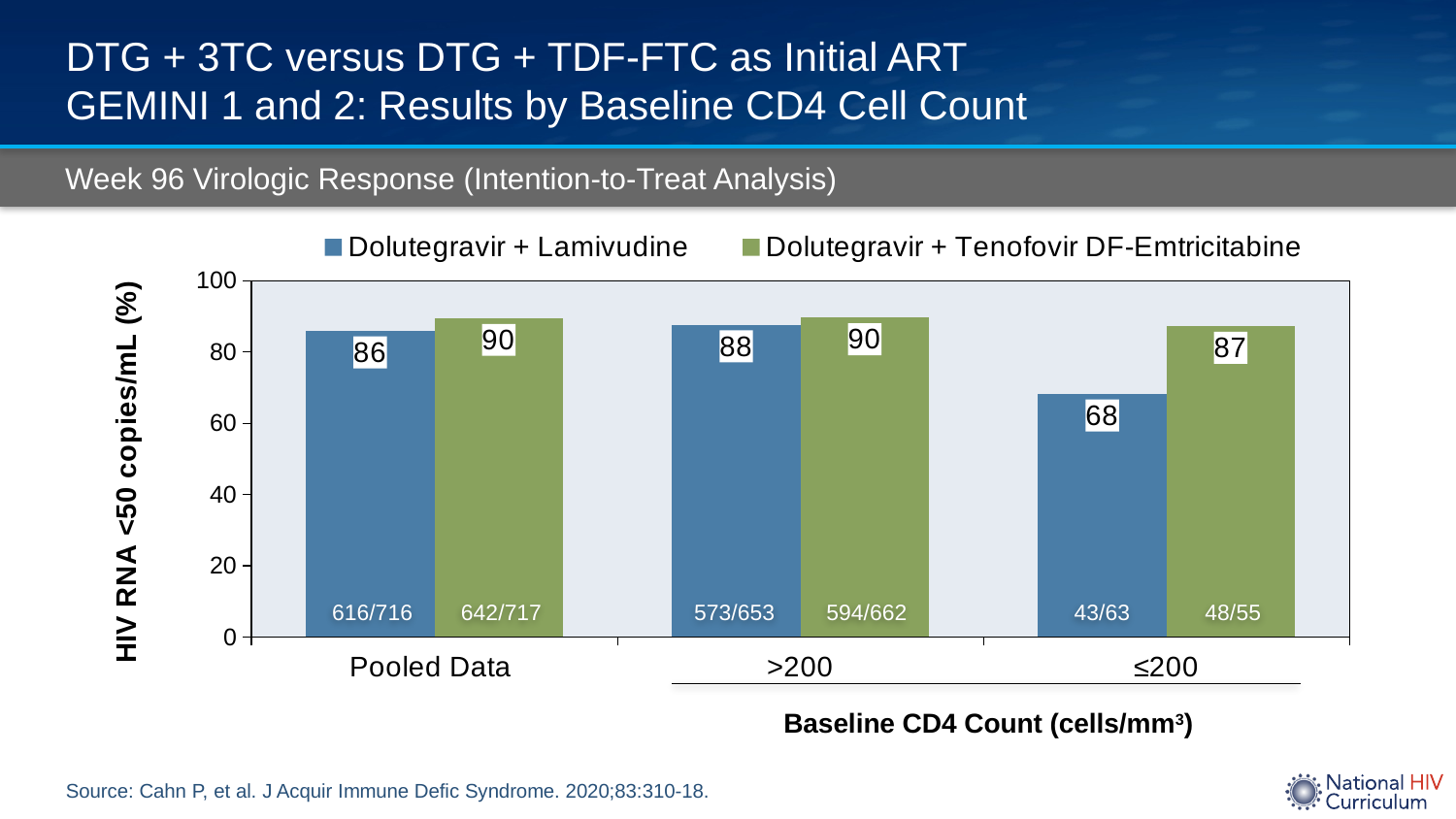
What kind of chart is shown on the slide? Bar chart How many baseline CD4 count categories are shown on the x axis? 3 What fraction is printed at the base of the Dolutegravir + Tenofovir DF-Emtricitabine bar in the >200 category? 594/662 How many series does the legend list? 2 Is the value for Dolutegravir + Lamivudine in the ≤200 category greater or less than 80? less What is the label of the y axis? HIV RNA <50 copies/mL (%) What is the value for Dolutegravir + Lamivudine in the >200 baseline CD4 count category? 88 Which category has the lowest value for Dolutegravir + Lamivudine? ≤200 What is the value for Dolutegravir + Lamivudine in the Pooled Data category? 86 What is the value for Dolutegravir + Tenofovir DF-Emtricitabine in the ≤200 baseline CD4 count category? 87 Which is larger in the Pooled Data category: Dolutegravir + Lamivudine or Dolutegravir + Tenofovir DF-Emtricitabine? Dolutegravir + Tenofovir DF-Emtricitabine What is the difference between the Dolutegravir + Tenofovir DF-Emtricitabine and Dolutegravir + Lamivudine values in the ≤200 category? 19